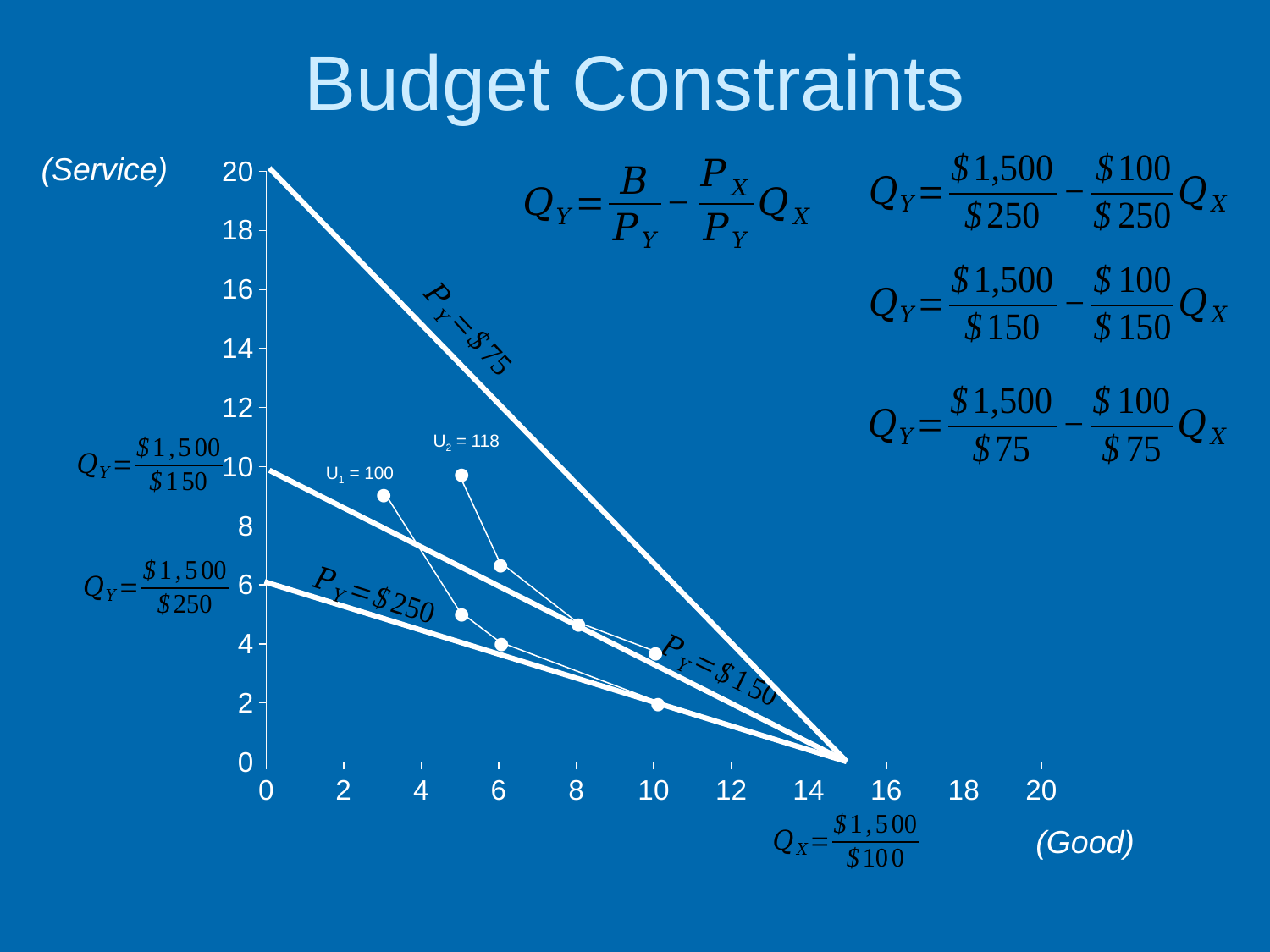
What is the title of the slide containing the chart? Budget Constraints What label is shown on the vertical axis of the chart? (Service) What kind of chart is shown on the slide? line chart Do the budget constraint lines rise or fall as the quantity of the good increases along the x axis? fall What is the difference between the vertical-axis intercepts of the P_Y = $75 line and the P_Y = $250 line? 14 Which budget line has the highest vertical-axis intercept? P_Y = $75 Which budget line has the lowest vertical-axis intercept? P_Y = $250 At what value does the P_Y = $250 budget line meet the vertical axis? 6 How many budget constraint lines are plotted on the chart? 3 At what value does the P_Y = $150 budget line meet the vertical axis? 10 Is the horizontal-axis intercept shared by the budget lines greater or less than 14? greater At what value does the P_Y = $75 budget line meet the vertical axis? 20